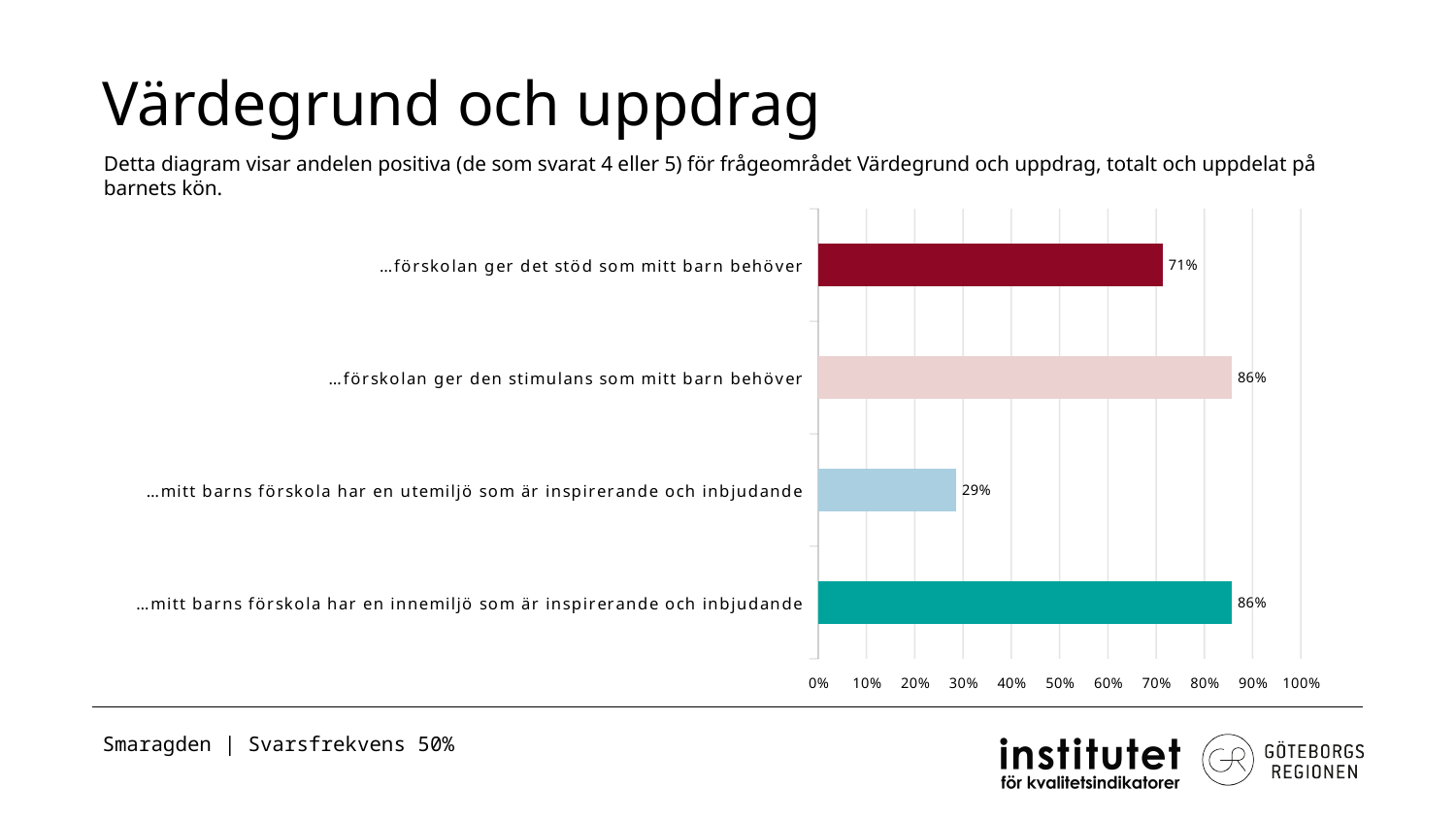
Which category has the lowest value? …mitt barns förskola har en utemiljö som är inspirerande och inbjudande What kind of chart is shown on the slide? bar chart What is the value for "…mitt barns förskola har en utemiljö som är inspirerande och inbjudande"? 29% What is the value for "…förskolan ger den stimulans som mitt barn behöver"? 86% How many categories are shown in the chart? 4 Is the value for "…förskolan ger det stöd som mitt barn behöver" greater or less than 50%? greater Which is larger: the value for "…förskolan ger det stöd som mitt barn behöver" or the value for "…mitt barns förskola har en utemiljö som är inspirerande och inbjudande"? …förskolan ger det stöd som mitt barn behöver What is the difference between the value for "…förskolan ger det stöd som mitt barn behöver" and the value for "…mitt barns förskola har en utemiljö som är inspirerande och inbjudande"? 42 percentage points What is the difference between the value for "…förskolan ger den stimulans som mitt barn behöver" and the value for "…förskolan ger det stöd som mitt barn behöver"? 15 percentage points What is the title of the slide containing the chart? Värdegrund och uppdrag What is the value for "…mitt barns förskola har en innemiljö som är inspirerande och inbjudande"? 86% What is the value for "…förskolan ger det stöd som mitt barn behöver"? 71%